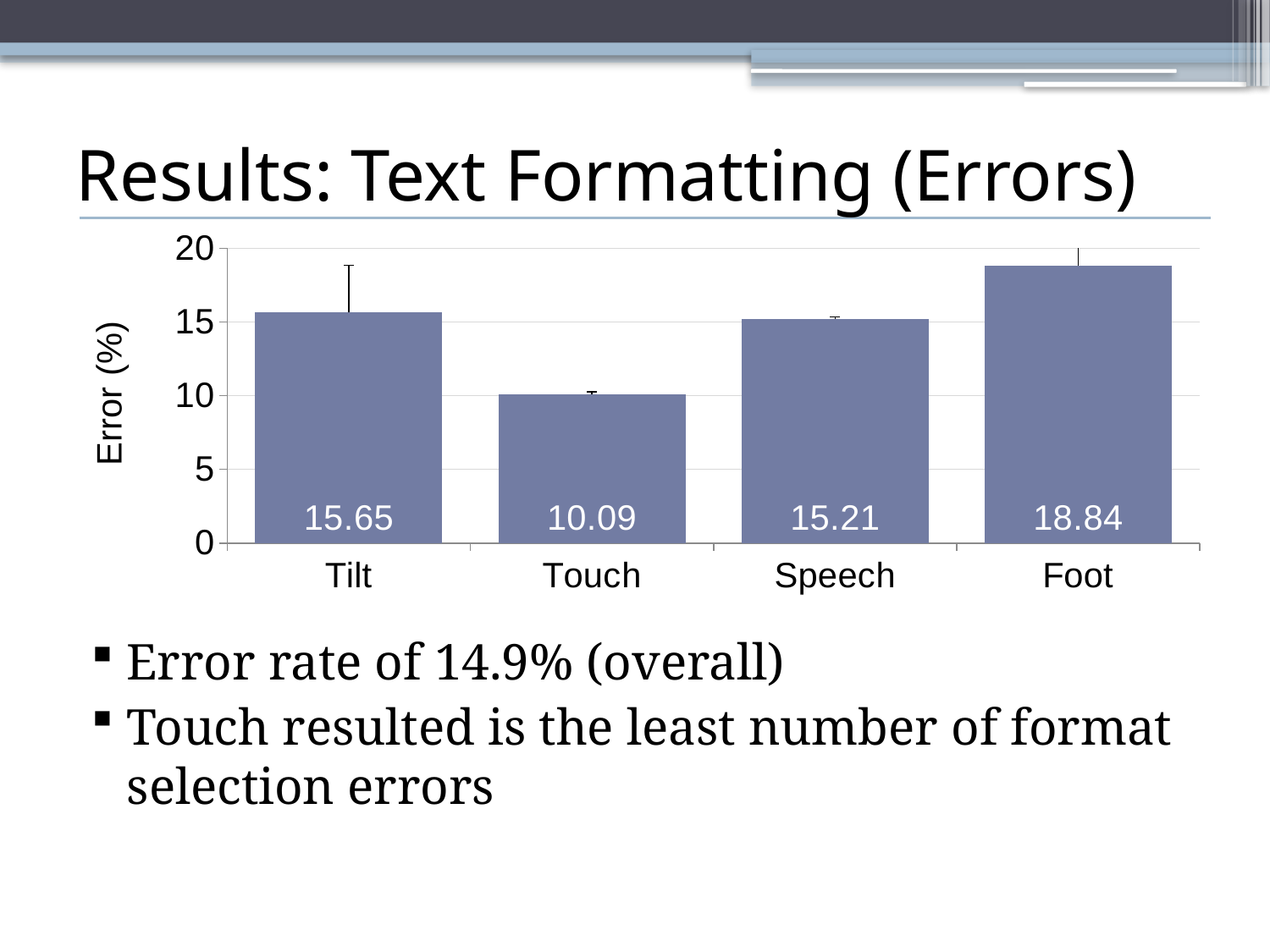
What is the error rate for Speech? 15.21 What is the error rate for Touch? 10.09 How many categories are shown on the x axis? 4 Which category has the highest error rate? Foot Is the value for Foot greater or less than 15? greater What is the difference between the error rates for Foot and Touch? 8.75 What is the error rate for Foot? 18.84 Which category has the lowest error rate? Touch What is the error rate for Tilt? 15.65 What is the difference between the error rates for Tilt and Speech? 0.44 Which has a higher error rate, Tilt or Touch? Tilt What kind of chart is shown on the slide? Bar chart